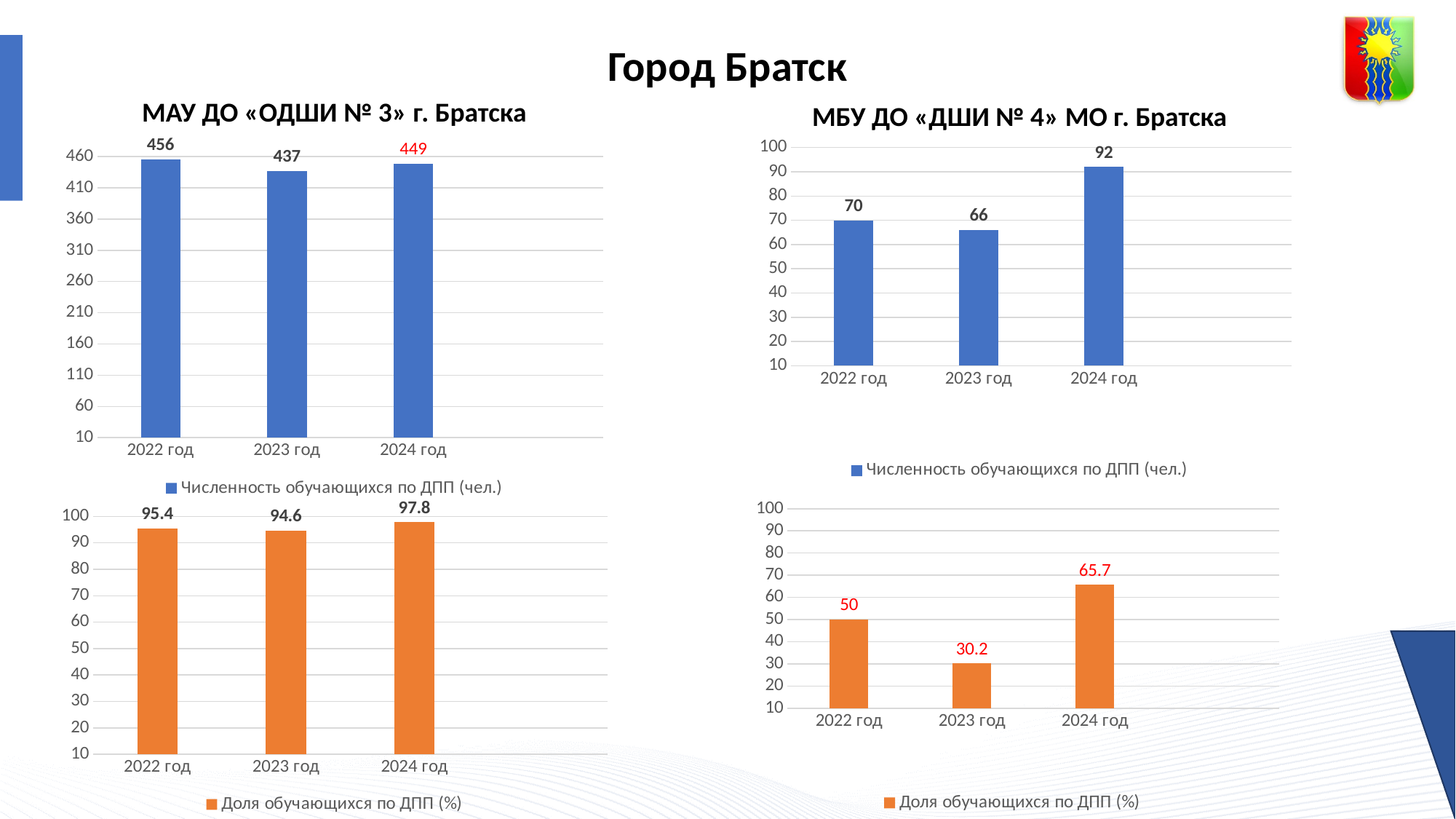
In the top-right chart (МБУ ДО «ДШИ № 4» МО г. Братска, Численность обучающихся по ДПП), what is the value for 2024 год? 92 In the bottom-right chart (МБУ ДО «ДШИ № 4» МО г. Братска, Доля обучающихся по ДПП (%)), which year has the lowest value? 2023 год In the top-right chart (МБУ ДО «ДШИ № 4» МО г. Братска, Численность обучающихся по ДПП), which year has the highest value? 2024 год In the top-right chart (МБУ ДО «ДШИ № 4» МО г. Братска, Численность обучающихся по ДПП), what is the difference between the 2024 год and 2023 год values? 26 In the bottom-right chart (МБУ ДО «ДШИ № 4» МО г. Братска, Доля обучающихся по ДПП (%)), what is the value for 2023 год? 30.2 What kind of chart is the top-left chart (МАУ ДО «ОДШИ № 3» г. Братска, Численность обучающихся по ДПП)? Bar chart In the bottom-left chart (МАУ ДО «ОДШИ № 3» г. Братска, Доля обучающихся по ДПП (%)), which is larger, 2022 год or 2023 год? 2022 год In the top-left chart (МАУ ДО «ОДШИ № 3» г. Братска, Численность обучающихся по ДПП), what is the difference between the 2022 год and 2024 год values? 7 In the top-left chart (МАУ ДО «ОДШИ № 3» г. Братска, Численность обучающихся по ДПП), which year has the lowest value? 2023 год In the bottom-left chart (МАУ ДО «ОДШИ № 3» г. Братска, Доля обучающихся по ДПП (%)), what is the value for 2024 год? 97.8 How many categories (years) are shown in the bottom-right chart (МБУ ДО «ДШИ № 4» МО г. Братска, Доля обучающихся по ДПП (%))? 3 In the top-left chart (МАУ ДО «ОДШИ № 3» г. Братска, Численность обучающихся по ДПП), what is the value for 2022 год? 456